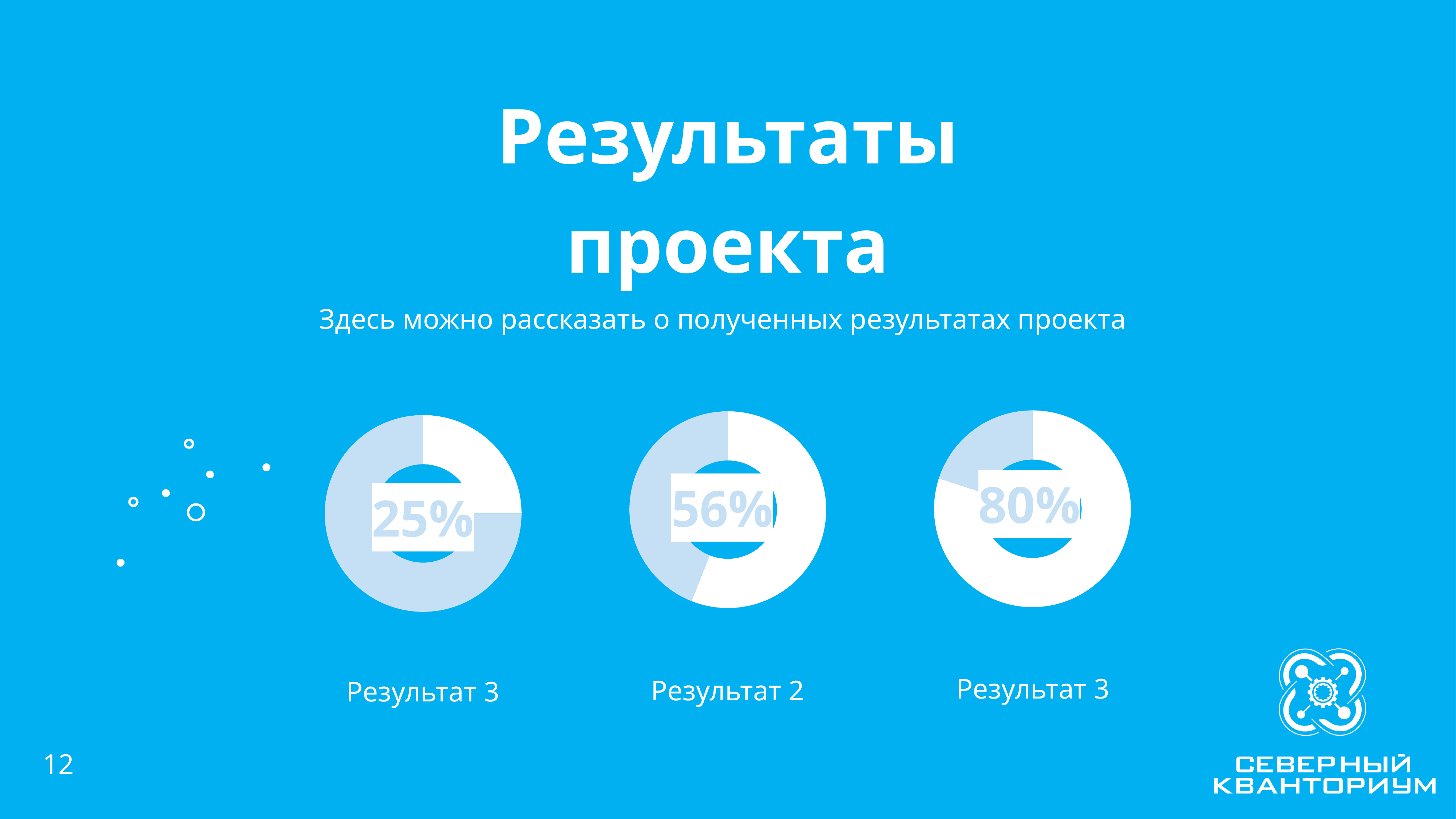
How many donut charts are shown on the slide? 3 What is the title of the slide containing the three donut charts? Результаты проекта Which is larger: the value in the middle donut chart or the value in the right donut chart? the right donut chart (80%) What value is shown in the left donut chart? 25% What value is shown in the right donut chart? 80% What is the label under the middle donut chart? Результат 2 Which of the three donut charts shows the lowest percentage: left, middle or right? left What value is shown in the middle donut chart, labelled Результат 2? 56% What is the difference between the value in the right donut chart and the value in the left donut chart? 55% What is the difference between the value in the middle donut chart and the value in the left donut chart? 31% Which of the three donut charts shows the highest percentage: left, middle or right? right What kind of chart is used to show the percentages on the slide? donut (pie) chart